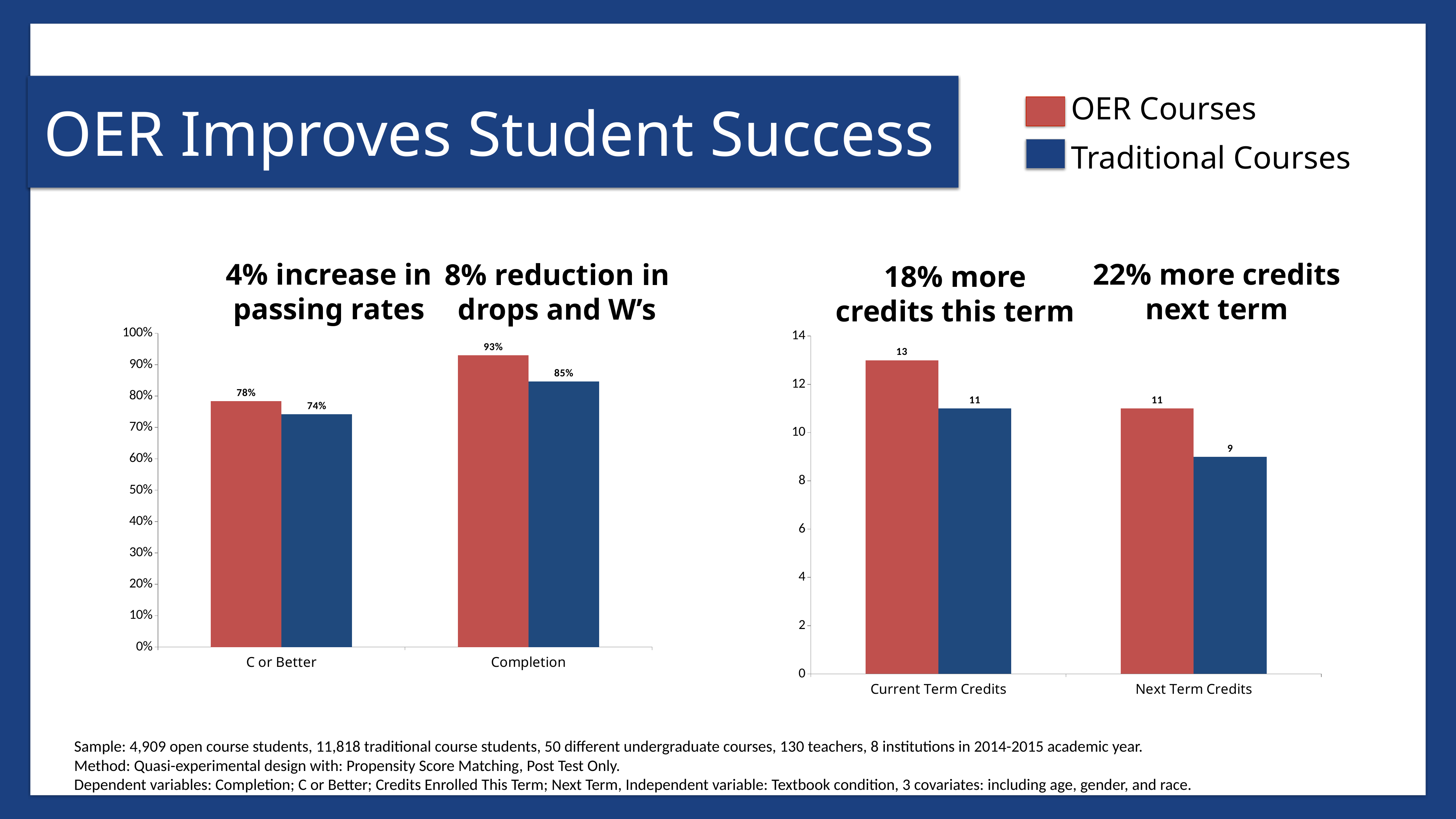
In the left chart, what is the difference between OER Courses and Traditional Courses in the Completion category? 8% How many series does the legend list? 2 In the left chart, what is the value for OER Courses in the C or Better category? 78% How many categories are shown on the x axis of the right chart? 2 In the left chart, what is the value for Traditional Courses in the Completion category? 85% In the right chart, what is the difference between OER Courses and Traditional Courses in Next Term Credits? 2 In the left chart, is the value for Traditional Courses in C or Better greater or less than 80%? less In the left chart, which series has the higher value in the C or Better category? OER Courses In the right chart, what is the value for Traditional Courses in Next Term Credits? 9 What type of chart is the left chart? Bar chart In the right chart, which category has the lowest bar? Next Term Credits In the right chart, what is the value for OER Courses in Current Term Credits? 13